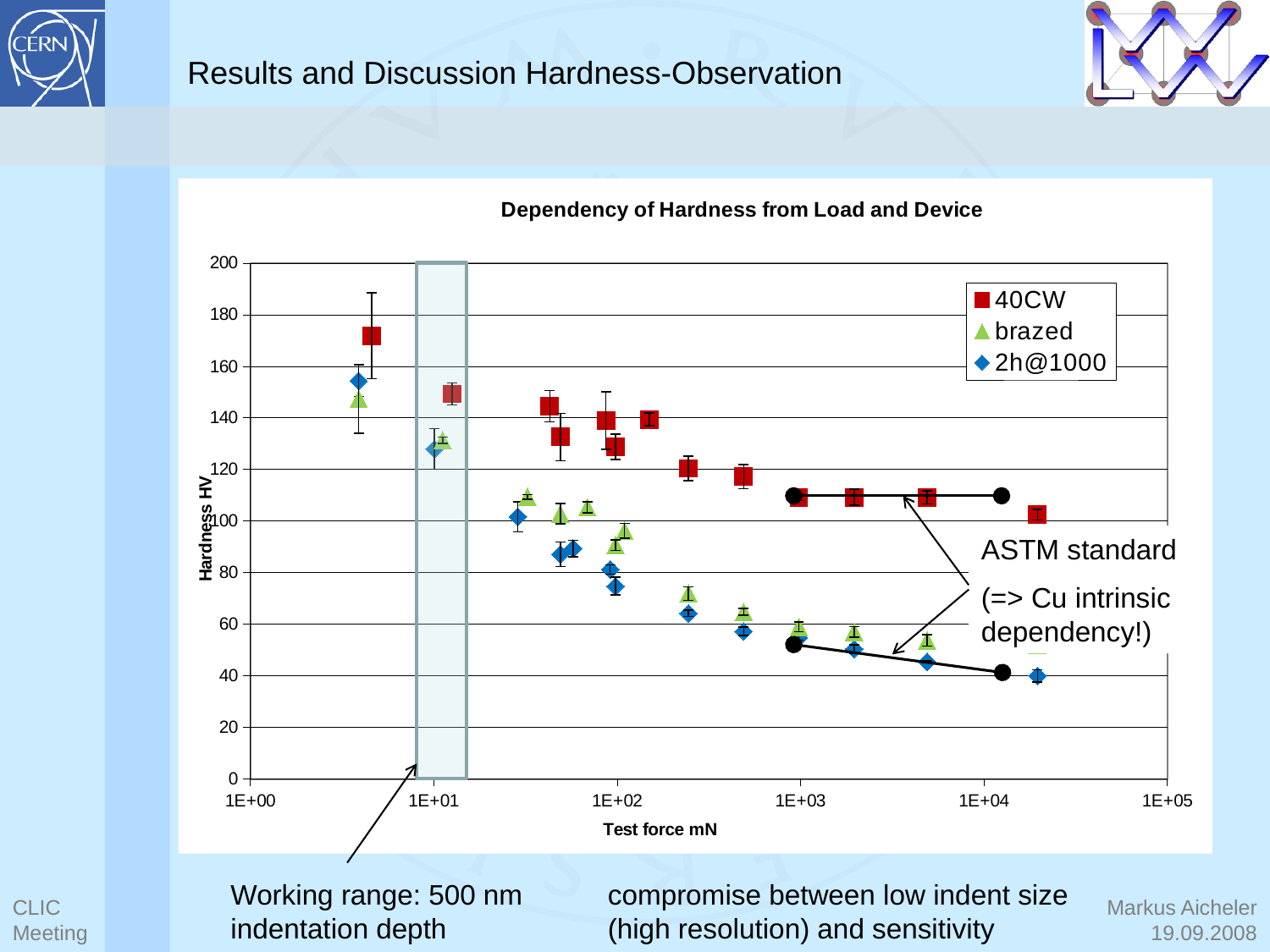
Is the hardness of the brazed series at a test force of about 1E+01 mN greater or less than 120? greater Does the hardness of the brazed series rise or fall as the test force increases? Fall Does the hardness of the 40CW series rise or fall as the test force increases? Fall What are the three series named in the chart legend? 40CW, brazed, 2h@1000 What kind of chart is shown on the slide? Scatter chart Is the hardness of the 40CW series at a test force of about 1E+03 mN greater or less than 100? greater What is the title of the chart? Dependency of Hardness from Load and Device Which series shows the highest hardness values across the chart? 40CW How many series does the legend of the chart list? 3 At a test force of about 1E+03 mN, which series has the larger hardness, 40CW or 2h@1000? 40CW Is the hardness of the 2h@1000 series at a test force of about 2E+04 mN greater or less than 60? less Which series shows the lowest hardness values at test forces above 1E+03 mN? 2h@1000